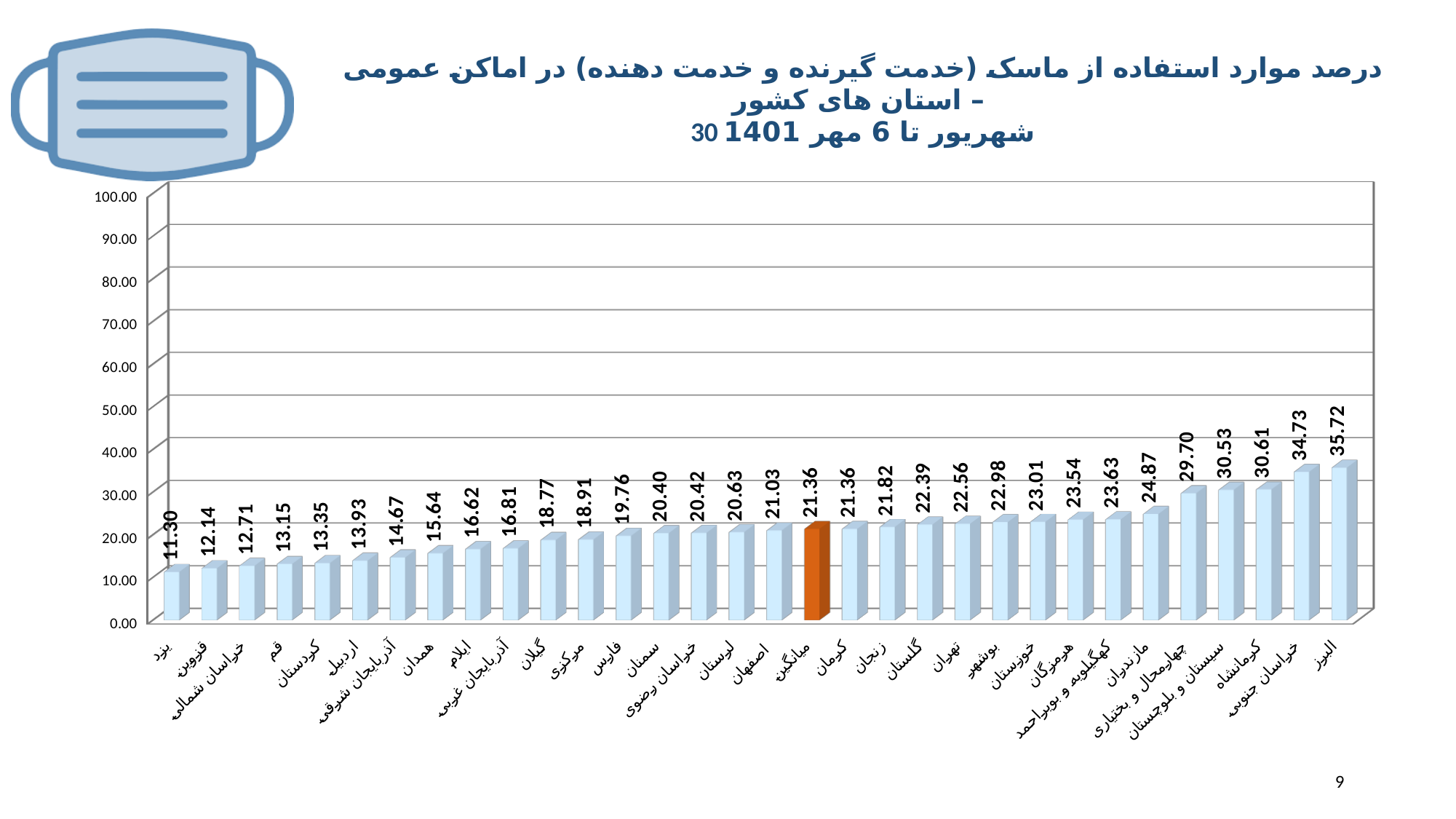
What is the value for تهران? 22.56 What is the value for البرز? 35.72 What is the difference between the values for البرز and یزد? 24.42 Is the value for خراسان جنوبی greater or less than 30.00? greater How many bars are plotted in the chart? 32 Which is larger, the value for کرمانشاه or the value for مازندران? کرمانشاه What is the value shown for the orange bar labelled میانگین? 21.36 Which bar is coloured orange instead of light blue? میانگین Do the values rise or fall from left to right along the x axis? rise What kind of chart is shown on the slide? bar chart Which category has the highest value? البرز Which category has the lowest value? یزد